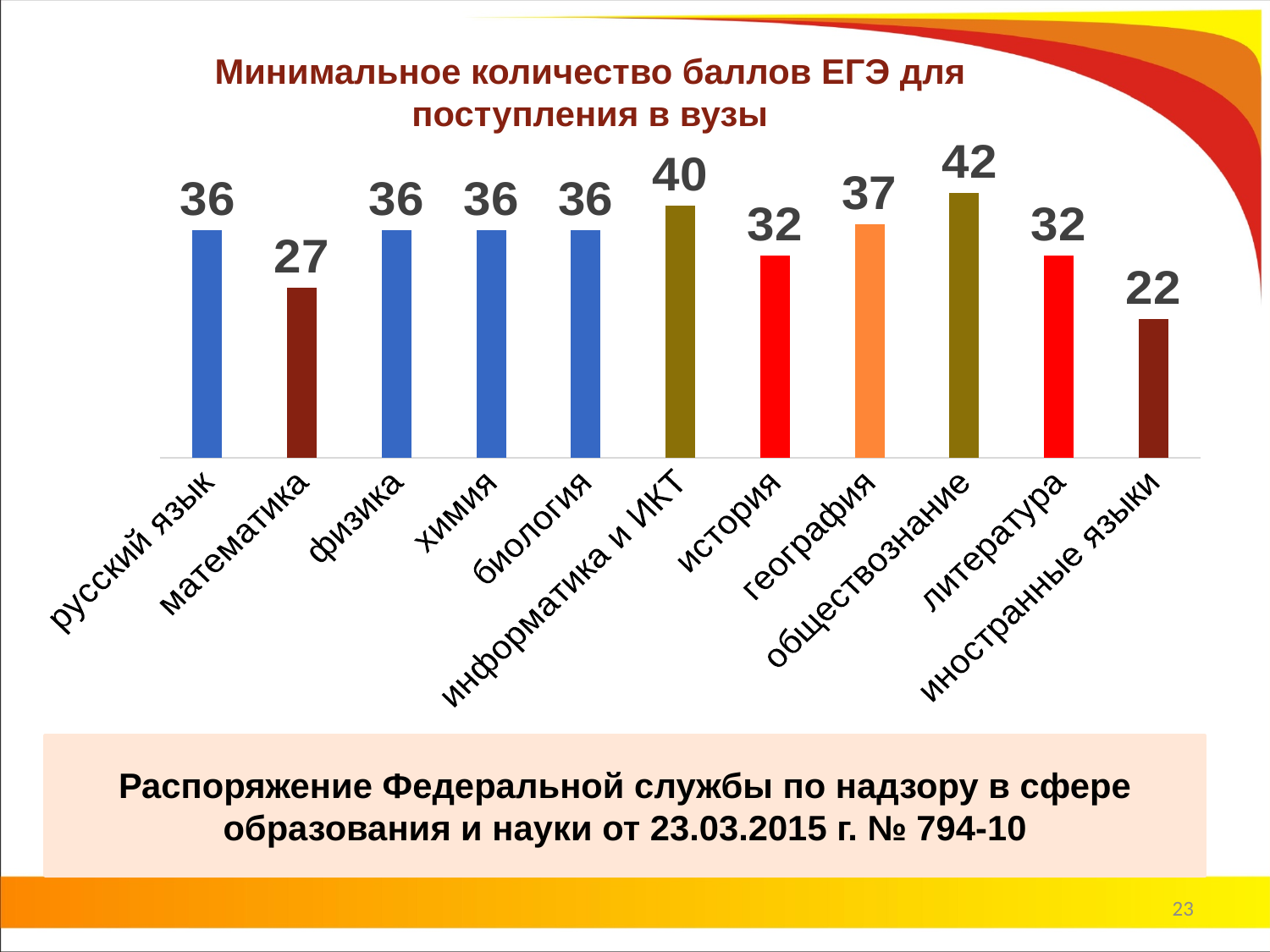
Which subject has the highest minimum score? обществознание What is the minimum score for математика? 27 What is the title of the chart? Минимальное количество баллов ЕГЭ для поступления в вузы What is the minimum score for информатика и ИКТ? 40 Which subject has the lowest minimum score? иностранные языки How many subjects are shown in the chart? 11 What is the minimum score for обществознание? 42 What is the difference between the minimum scores for обществознание and математика? 15 What is the minimum score for иностранные языки? 22 What kind of chart is shown on the slide? bar chart What is the difference between the minimum scores for география and история? 5 Which has a higher minimum score, информатика и ИКТ or география? информатика и ИКТ